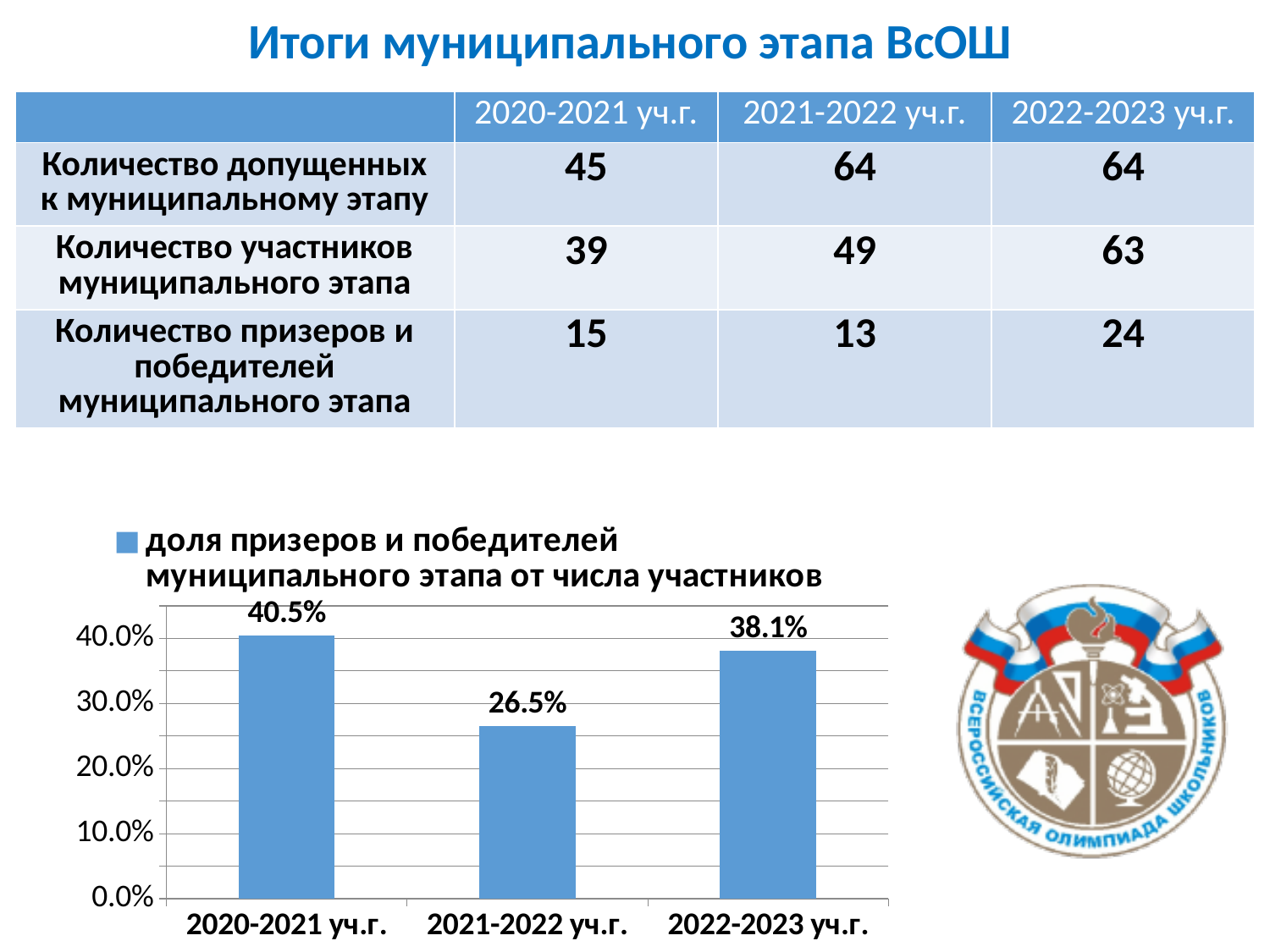
What kind of chart is shown on the slide? bar chart Which academic year has the highest value in the bar chart? 2020-2021 уч.г. How many series does the legend of the bar chart list? 1 In the bar chart, which is larger: the value for 2020-2021 уч.г. or the value for 2022-2023 уч.г.? 2020-2021 уч.г. Which academic year has the lowest value in the bar chart? 2021-2022 уч.г. How many bars are shown in the bar chart? 3 What is the value for 2020-2021 уч.г. in the bar chart? 40.5% Is the value for 2021-2022 уч.г. in the bar chart greater or less than 30.0%? less What is the value for 2021-2022 уч.г. in the bar chart? 26.5% What is the value for 2022-2023 уч.г. in the bar chart? 38.1% What is the difference between the values for 2020-2021 уч.г. and 2021-2022 уч.г. in the bar chart? 14.0% What is the difference between the values for 2022-2023 уч.г. and 2021-2022 уч.г. in the bar chart? 11.6%